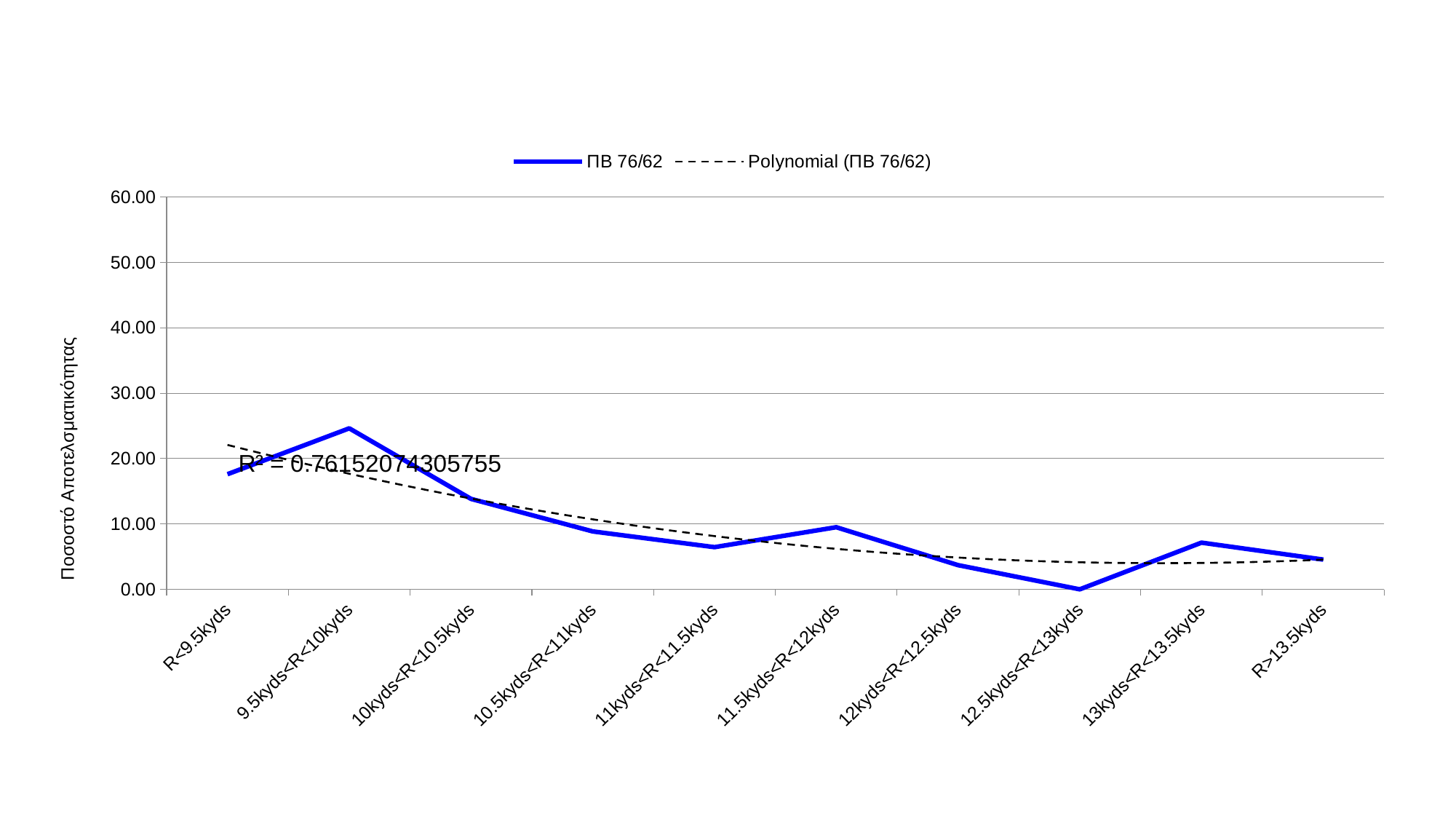
What R² value is printed on the chart? 0.76152074305755 Which is larger for ΠΒ 76/62: the value at R<9.5kyds or the value at 10kyds<R<10.5kyds? R<9.5kyds Which is larger for ΠΒ 76/62: the value at 11.5kyds<R<12kyds or the value at 12.5kyds<R<13kyds? 11.5kyds<R<12kyds Is the value for ΠΒ 76/62 at 12kyds<R<12.5kyds greater or less than 10.00? less How many categories are shown along the x axis? 10 Which category has the lowest value for ΠΒ 76/62? 12.5kyds<R<13kyds Which category has the highest value for ΠΒ 76/62? 9.5kyds<R<10kyds Is the value for ΠΒ 76/62 at 9.5kyds<R<10kyds greater or less than 20.00? greater What kind of chart is shown on the slide? line chart How many entries does the legend list? 2 Overall, do the ΠΒ 76/62 values rise or fall from left to right along the x axis? fall Is the value for ΠΒ 76/62 at R<9.5kyds greater or less than 10.00? greater